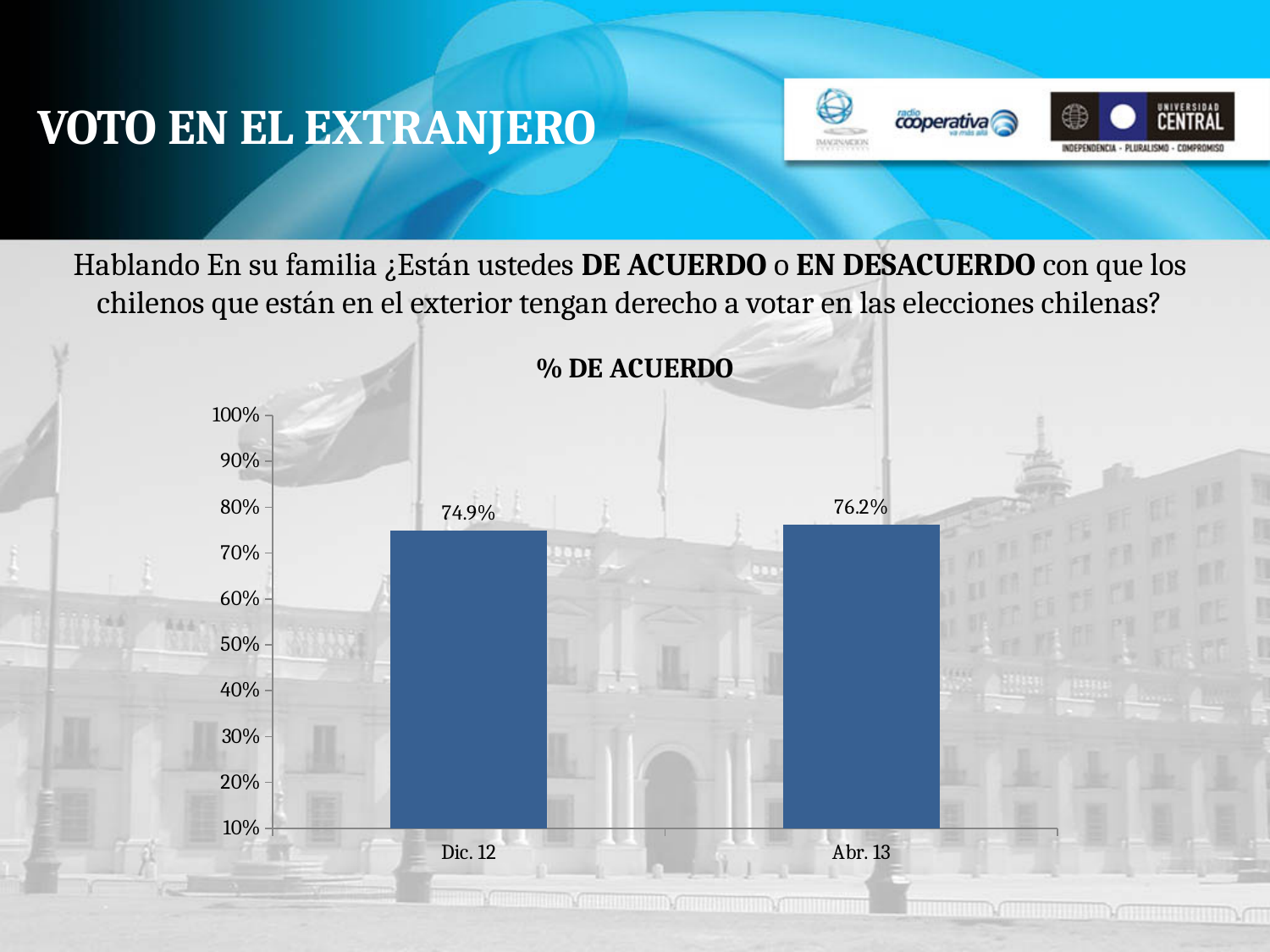
How many categories are shown on the x axis? 2 What kind of chart is shown on the slide? bar chart Which category has the lowest value? Dic. 12 What is the title of the chart? % DE ACUERDO What is the value for Dic. 12? 74.9% What is the value for Abr. 13? 76.2% Is the value for Abr. 13 greater or less than 80%? less What is the difference between the values for Abr. 13 and Dic. 12? 1.3% Which category has the highest value? Abr. 13 Which is larger, the value for Dic. 12 or the value for Abr. 13? Abr. 13 Is the value for Dic. 12 greater or less than 70%? greater Do the values rise or fall from Dic. 12 to Abr. 13? rise